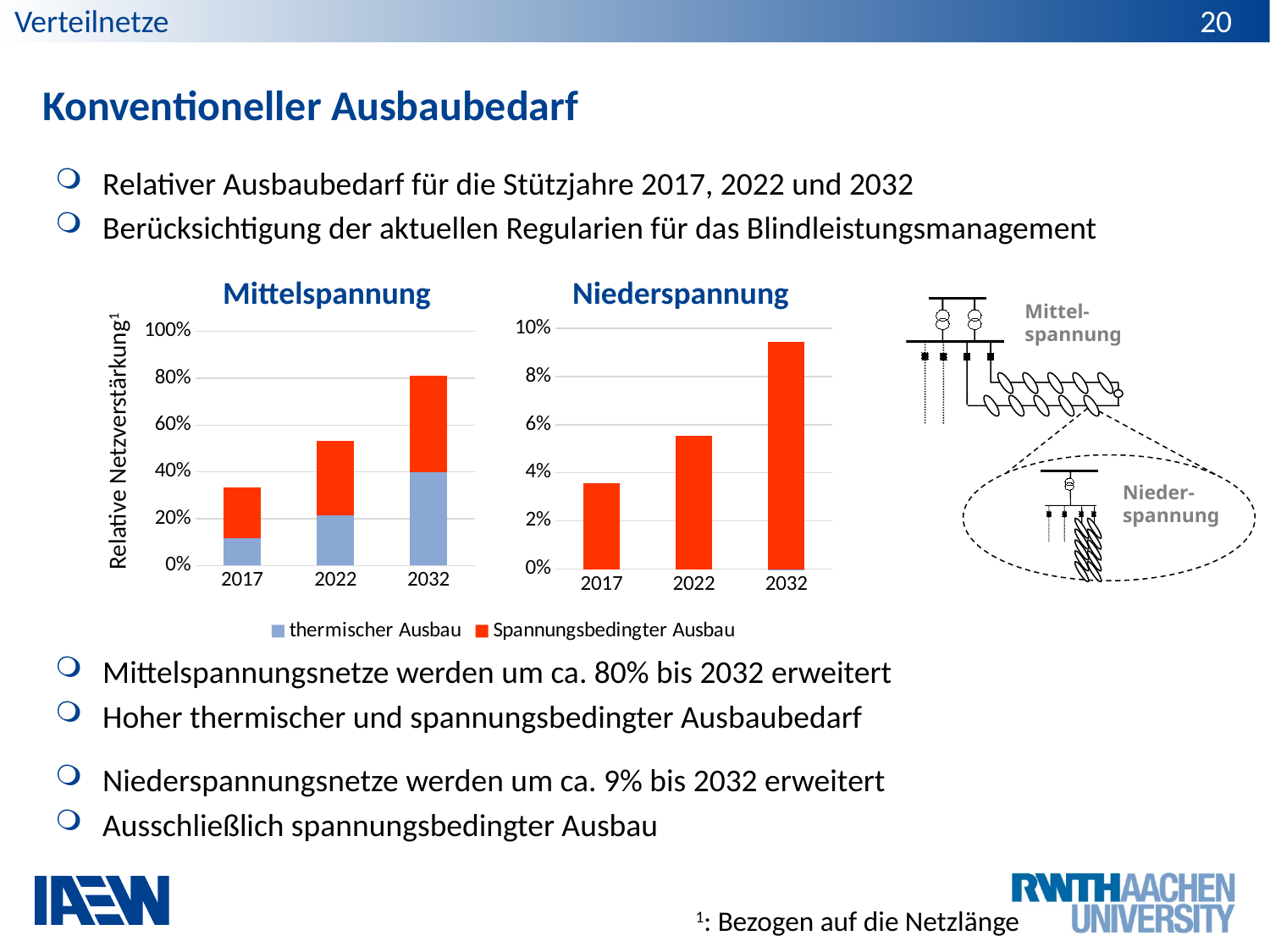
In the Niederspannung chart, do the values rise or fall from 2017 to 2032? rise In the Niederspannung chart, is the value for 2017 greater or less than 4%? less What kind of chart is the Mittelspannung chart? stacked bar chart In the Mittelspannung chart, which year has the highest total relative Netzverstärkung? 2032 How many series does the legend below the charts list? 2 In the Niederspannung chart, which year has the highest value? 2032 In the Niederspannung chart, is the value for 2032 greater or less than 8%? greater In the Mittelspannung chart, is the total value for 2017 greater or less than 40%? less In the Mittelspannung chart, which year has the lowest total relative Netzverstärkung? 2017 How many years are shown on the x axis of the Niederspannung chart? 3